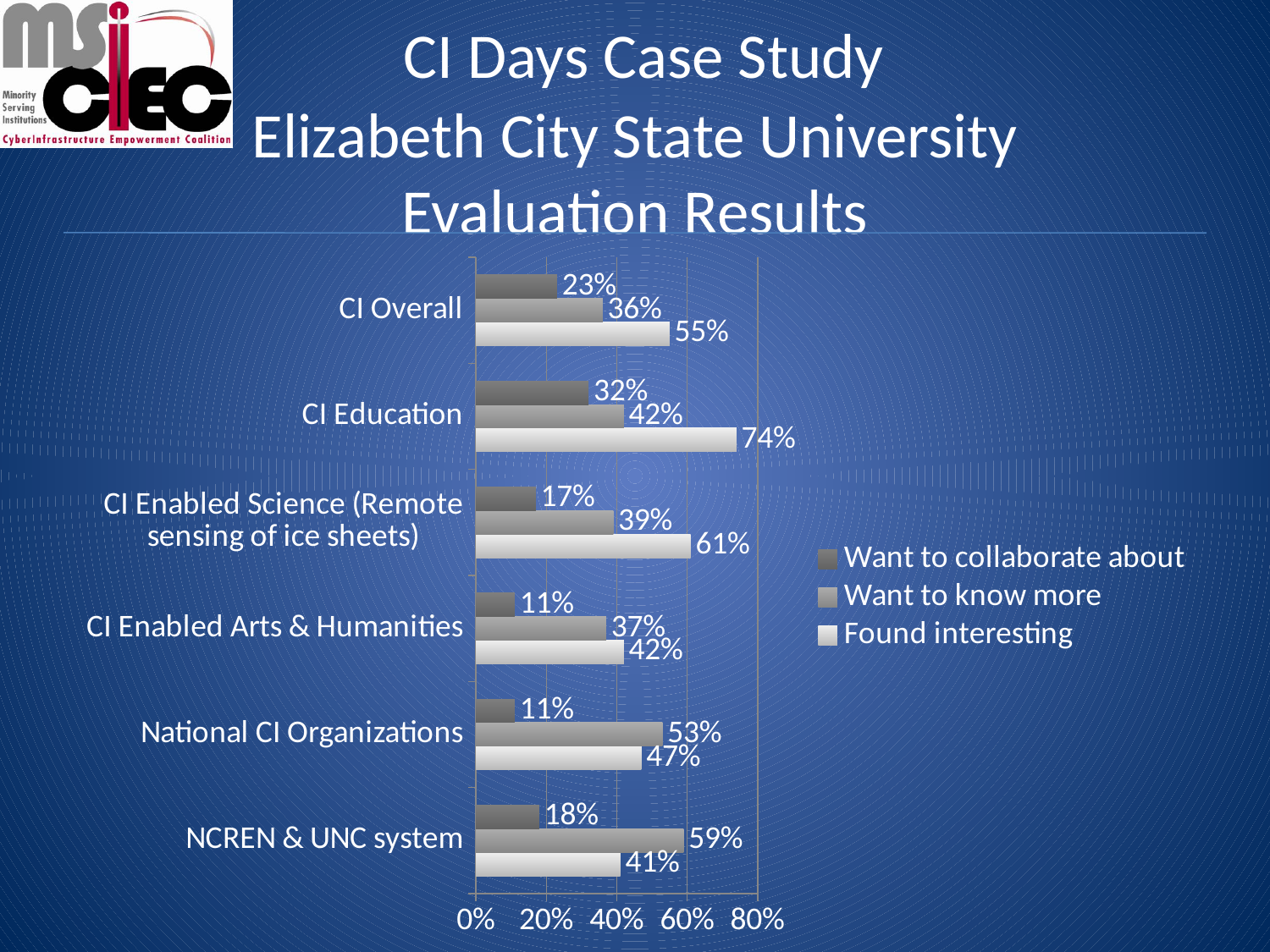
What percentage of respondents found CI Education interesting? 74% What kind of chart is shown on the slide? Bar chart How many categories are shown on the chart? 6 For National CI Organizations, which is larger: 'Want to know more' or 'Found interesting'? Want to know more Is the 'Found interesting' value for CI Enabled Science (Remote sensing of ice sheets) greater or less than 40%? greater How many series does the legend list? 3 Which category has the lowest 'Want to know more' value? CI Overall What is the difference between the 'Found interesting' and 'Want to collaborate about' values for CI Overall? 32% What is the 'Want to collaborate about' value for CI Enabled Science (Remote sensing of ice sheets)? 17% What is the 'Want to know more' value for NCREN & UNC system? 59% Which category has the highest 'Found interesting' value? CI Education Which series is shown in the lightest colour in the legend? Found interesting